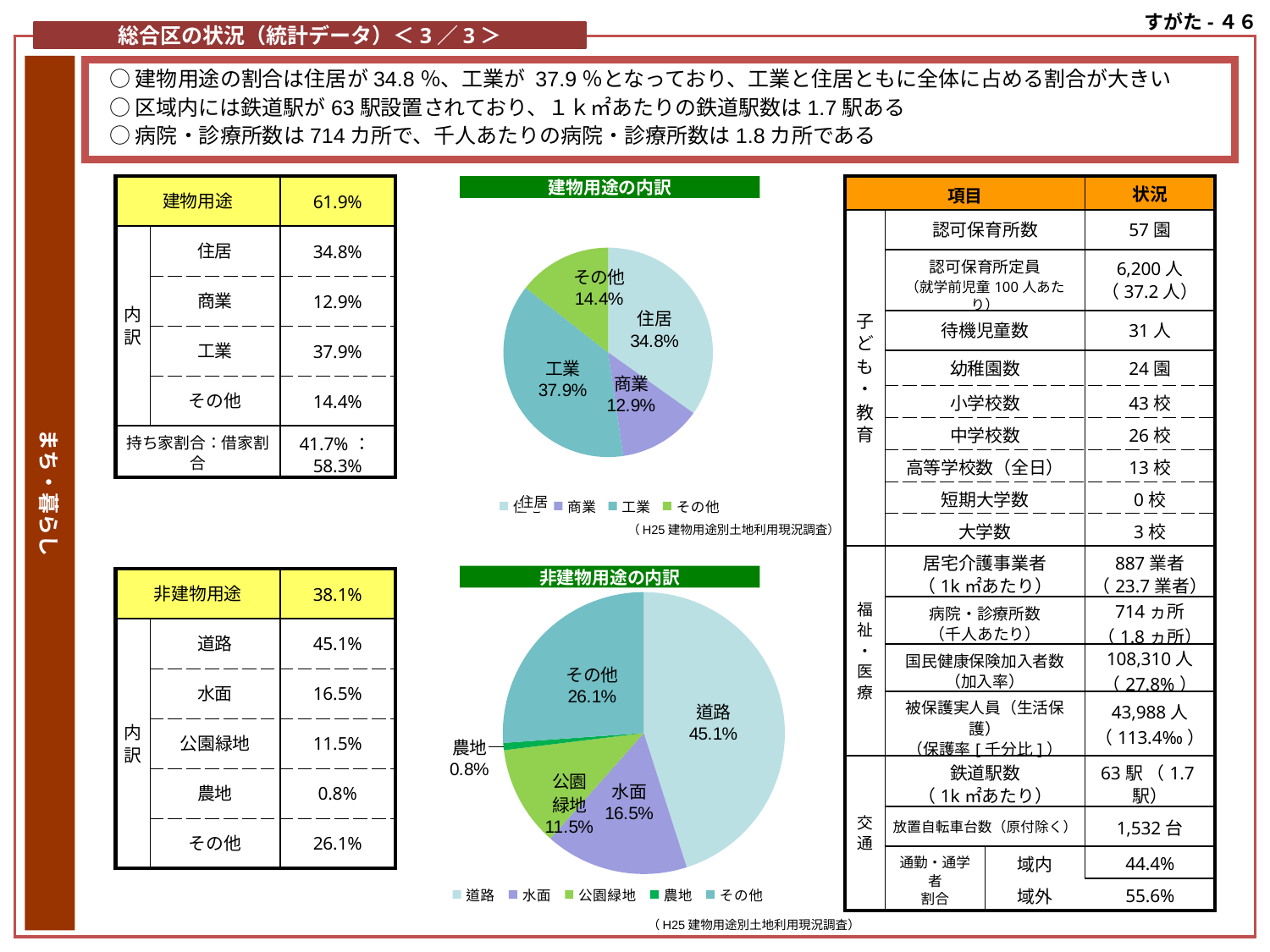
In the 非建物用途の内訳 pie chart, which is larger, その他 or 公園緑地? その他 In the 建物用途の内訳 pie chart, what is the share for 住居? 34.8% In the 建物用途の内訳 pie chart, which category has the largest share? 工業 In the 非建物用途の内訳 pie chart, what is the difference between the shares of 道路 and その他? 19.0% In the 非建物用途の内訳 pie chart, which category has the largest share? 道路 In the 建物用途の内訳 pie chart, what is the difference between the shares of 工業 and 住居? 3.1% In the 非建物用途の内訳 pie chart, what is the share for 水面? 16.5% In the 建物用途の内訳 pie chart, which category has the smallest share? 商業 How many categories does the legend of the 建物用途の内訳 pie chart list? 4 What kind of chart is 建物用途の内訳? Pie chart In the 非建物用途の内訳 pie chart, which category has the smallest share? 農地 How many slices does the 非建物用途の内訳 pie chart have? 5